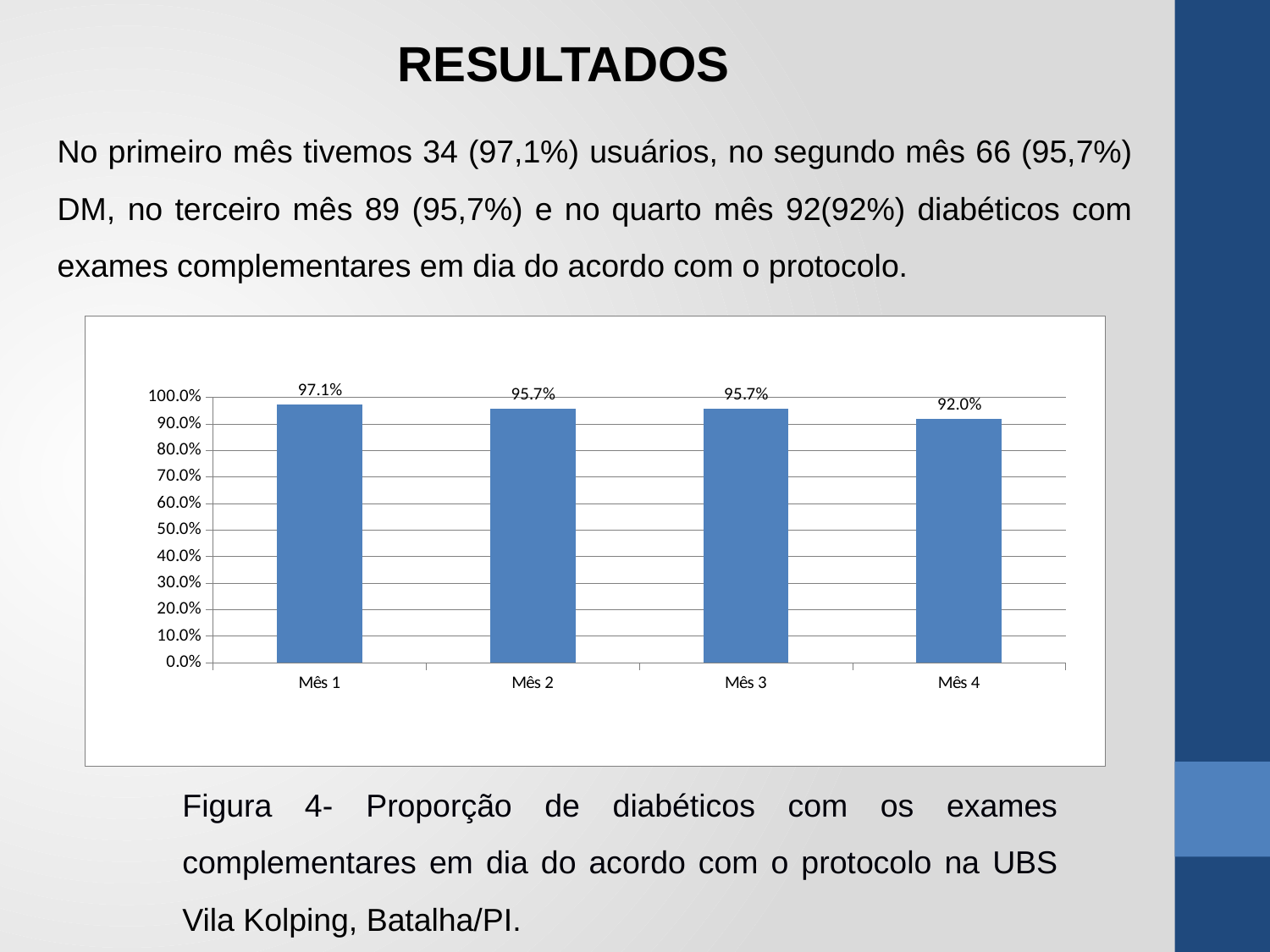
What is the value for Mês 1? 97.1% What kind of chart is shown on the slide? bar chart What is the difference between the values for Mês 2 and Mês 4? 3.7% Which is larger, the value for Mês 1 or the value for Mês 4? Mês 1 What is the difference between the values for Mês 1 and Mês 4? 5.1% Which month has the highest value? Mês 1 How many months are shown on the x axis? 4 Do the values rise or fall from Mês 1 to Mês 4? fall Which month has the lowest value? Mês 4 Is the value for Mês 4 greater or less than 90.0%? greater What is the value for Mês 4? 92.0% What is the value for Mês 2? 95.7%